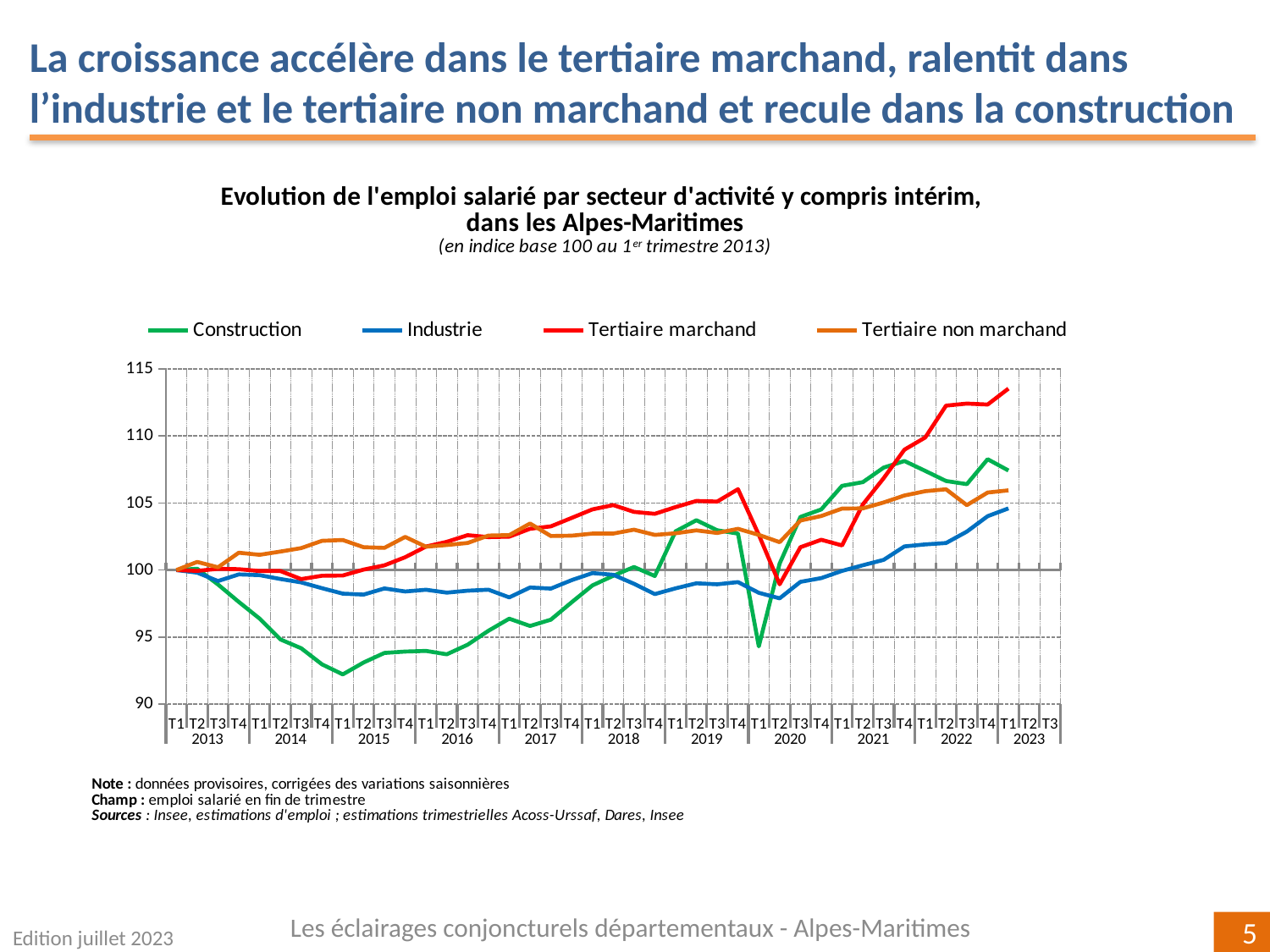
Which series has the lowest value at T1 2015? Construction Does the Construction series rise or fall between T1 2013 and T1 2015? fall Which series has the highest value at T1 2023? Tertiaire marchand What is the base value of the index, as stated in the chart subtitle? 100 au 1er trimestre 2013 How many series does the legend list? 4 Which series is drawn in green? Construction Is the value for Industrie at T1 2023 greater or less than 100? greater At T1 2023, which is higher: Construction or Industrie? Construction Is the value for Construction at T1 2015 greater or less than 95? less Is the value for Tertiaire marchand at T1 2023 greater or less than 110? greater What kind of chart is shown on the slide? line chart